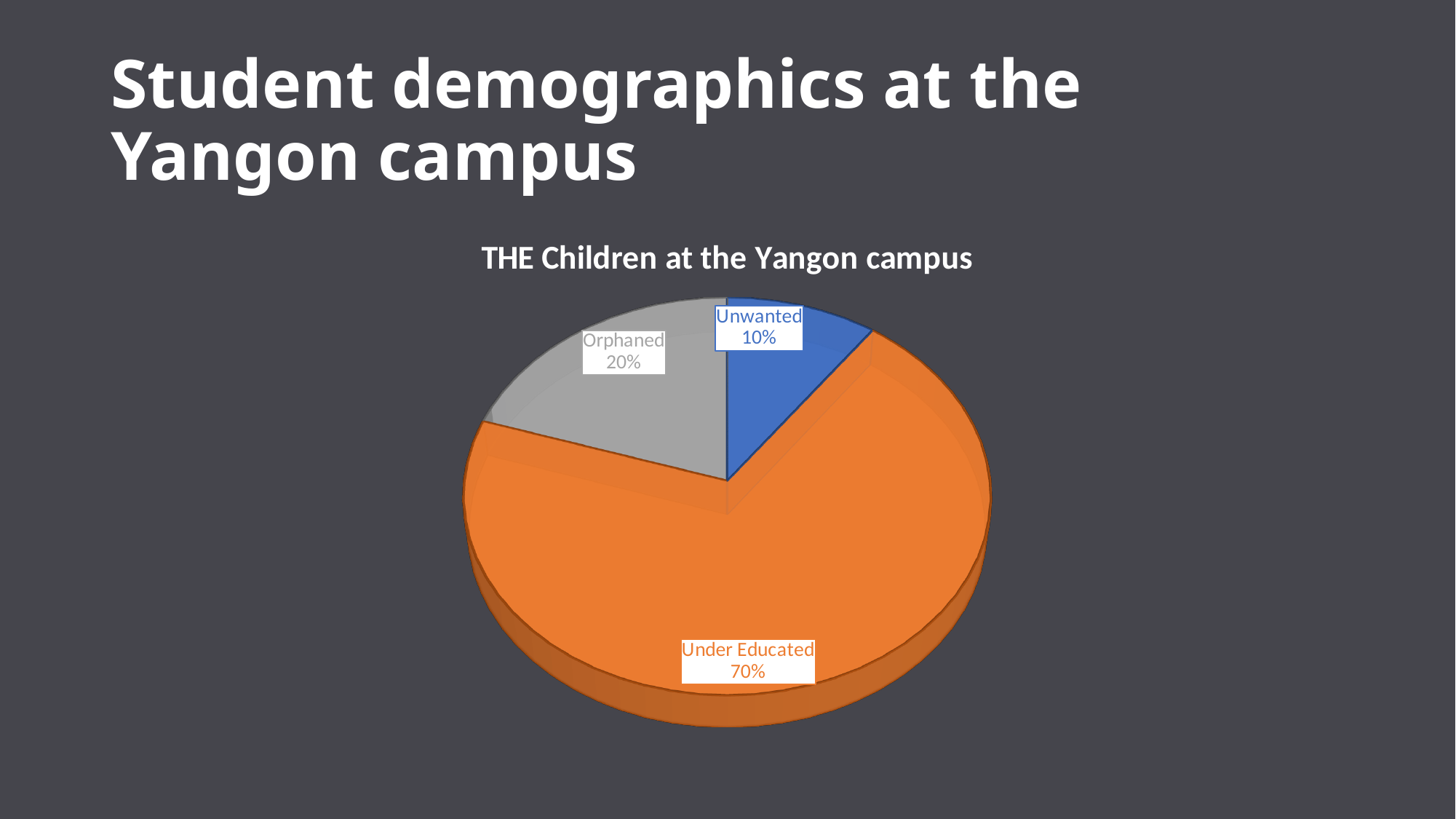
What is the difference in percentage points between the Under Educated and Orphaned slices? 50 What percentage of children at the Yangon campus are Under Educated? 70% Which slice is larger, Orphaned or Unwanted? Orphaned What is the title of the chart? THE Children at the Yangon campus What is the difference in percentage points between the Orphaned and Unwanted slices? 10 What percentage of children at the Yangon campus are Orphaned? 20% What colour is the Under Educated slice? Orange What percentage of children at the Yangon campus are Unwanted? 10% How many categories are shown in the pie chart? 3 Which category has the smallest share of the pie? Unwanted What type of chart is shown on the slide? Pie chart Which category has the largest share of the pie? Under Educated